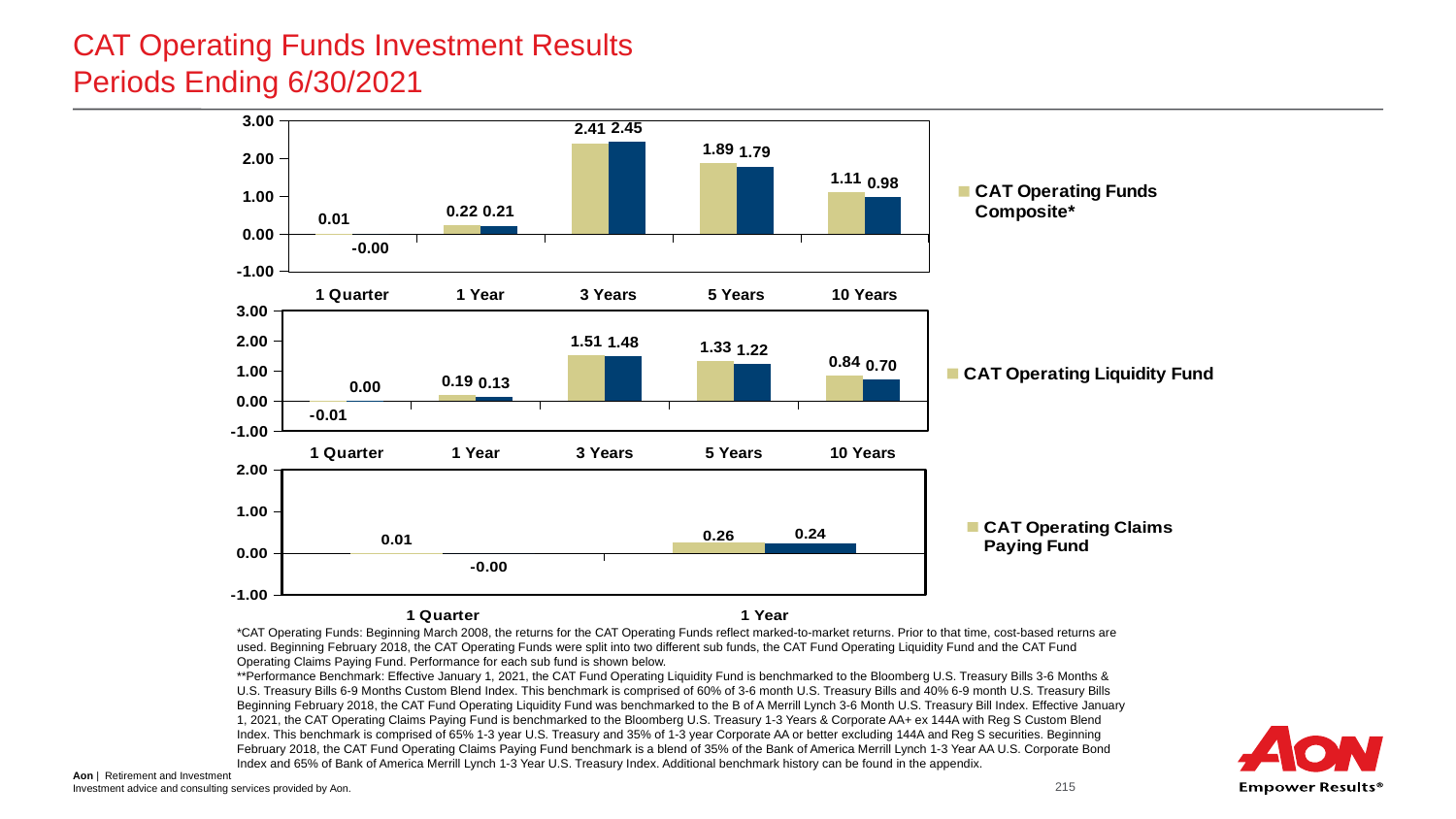
In the CAT Operating Claims Paying Fund chart (bottom), how many periods are shown on the x axis? 2 In the CAT Operating Funds Composite chart (top), what is the value of the blue bar for 10 Years? 0.98 In the CAT Operating Funds Composite chart (top), which period has the highest value for the CAT Operating Funds Composite? 3 Years In the CAT Operating Liquidity Fund chart (middle), what is the value of the CAT Operating Liquidity Fund for 5 Years? 1.33 In the CAT Operating Claims Paying Fund chart (bottom), is the CAT Operating Claims Paying Fund value for 1 Year larger or smaller than the blue bar value for 1 Year? larger What kind of chart is the CAT Operating Funds Composite chart (top)? bar chart In the CAT Operating Funds Composite chart (top), what is the value of the CAT Operating Funds Composite for 3 Years? 2.41 In the CAT Operating Liquidity Fund chart (middle), how many periods are shown on the x axis? 5 In the CAT Operating Funds Composite chart (top), what is the difference between the CAT Operating Funds Composite value and the blue bar value for 5 Years? 0.10 In the CAT Operating Liquidity Fund chart (middle), what is the value of the blue bar for 1 Year? 0.13 In the CAT Operating Liquidity Fund chart (middle), which period has the lowest value for the CAT Operating Liquidity Fund? 1 Quarter In the CAT Operating Claims Paying Fund chart (bottom), what is the value of the CAT Operating Claims Paying Fund for 1 Year? 0.26